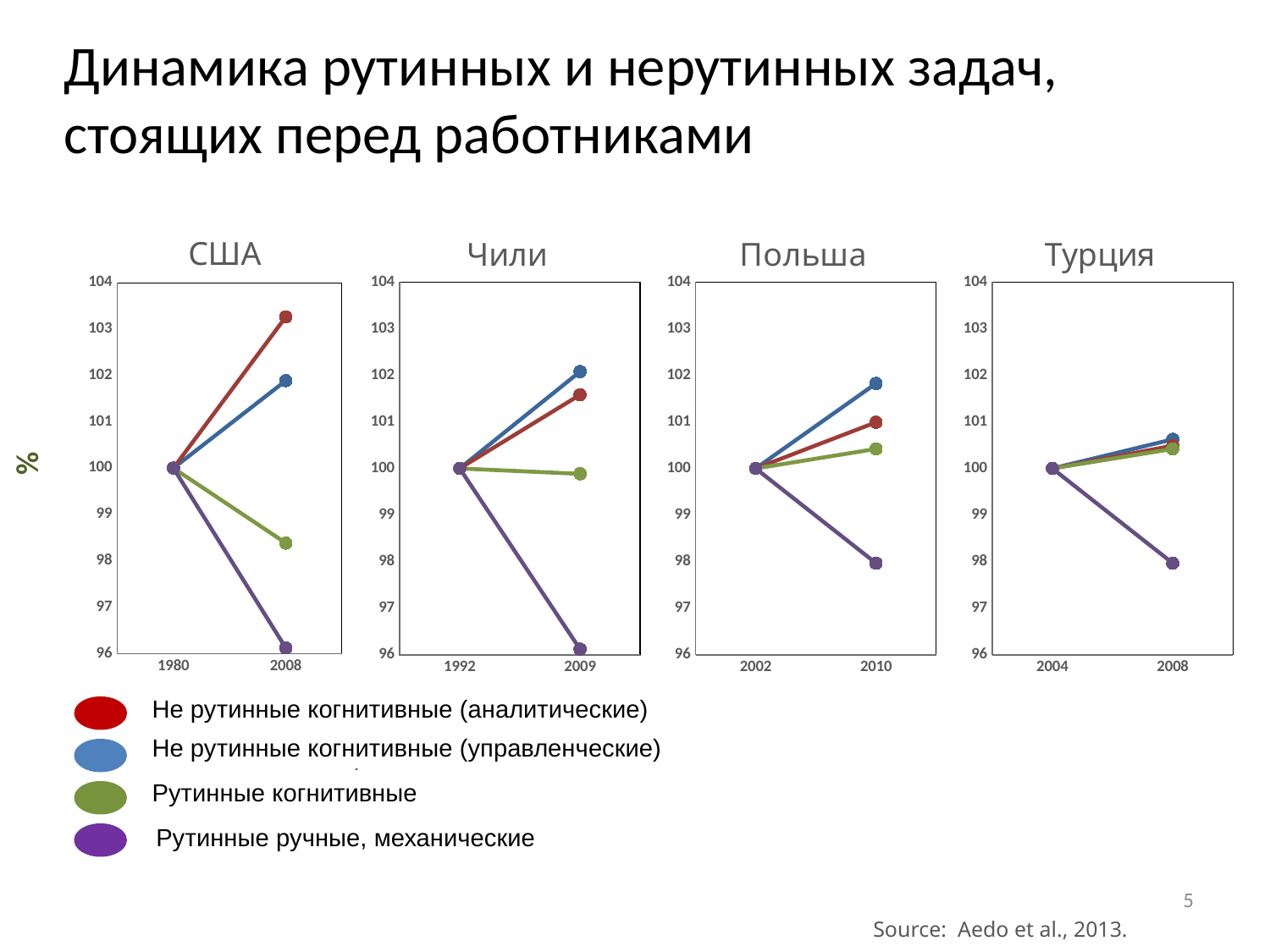
What are the two years shown on the x axis of the Турция chart? 2004 and 2008 In the Чили chart, which series has the highest value in 2009? Не рутинные когнитивные (управленческие) In the США chart, which series has the highest value in 2008? Не рутинные когнитивные (аналитические) In the США chart, is the value for Рутинные ручные, механические in 2008 greater or less than 97? less In the Турция chart, is the value for Рутинные ручные, механические in 2008 greater or less than 99? less In the Чили chart, does the value for Рутинные ручные, механические rise or fall from 1992 to 2009? fall How many series does the legend list? 4 In the Польша chart, which series has the lowest value in 2010? Рутинные ручные, механические In the США chart, is the value for Не рутинные когнитивные (аналитические) in 2008 greater or less than 102? greater What kind of chart is used for the США panel? line chart In the США chart, how many years are shown on the x axis? 2 In the США chart, what is the value of all series in 1980? 100